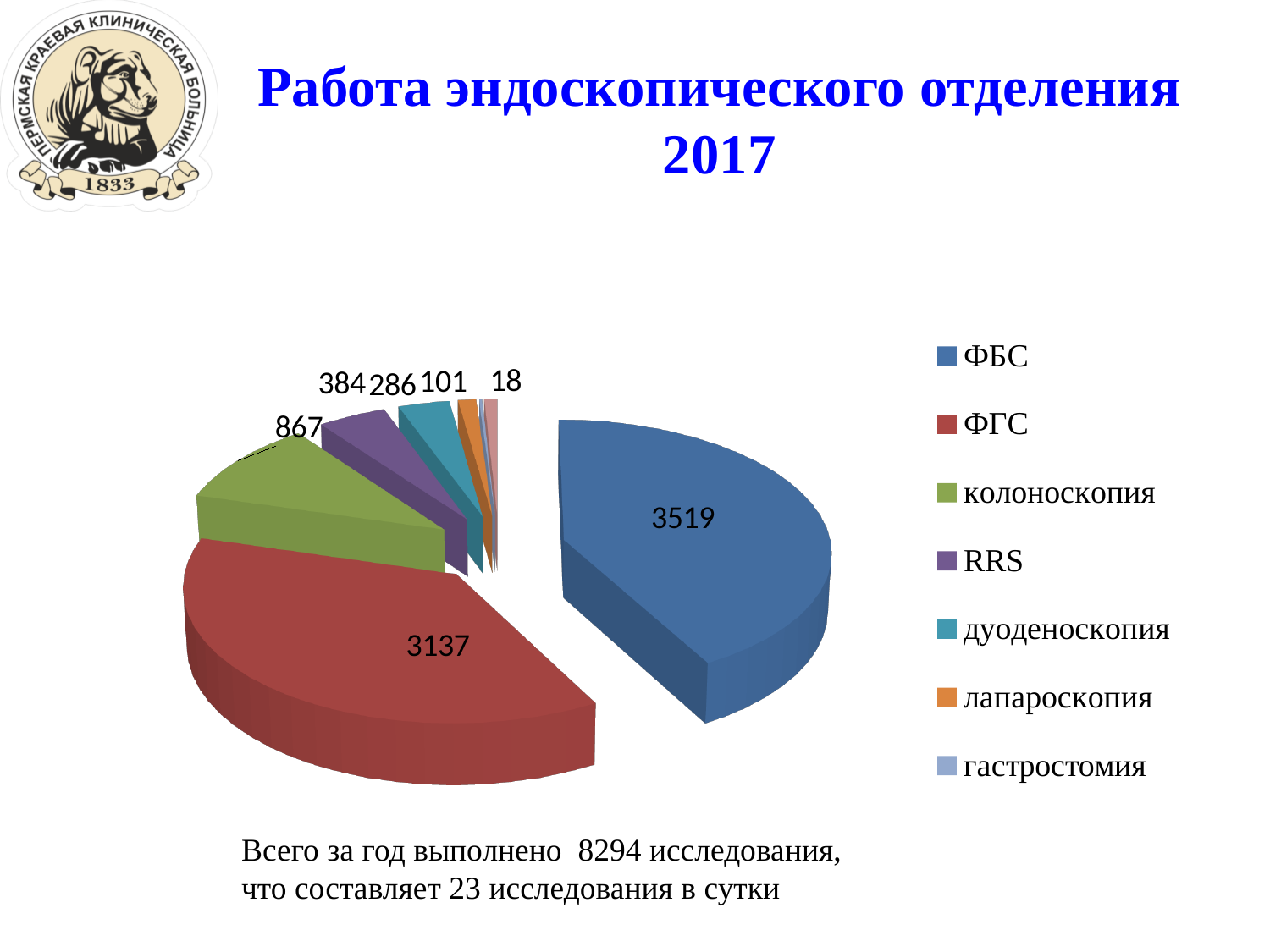
What is the difference between the values for ФБС and ФГС? 382 Which is larger, the value for дуоденоскопия or the value for лапароскопия? дуоденоскопия Which category has the largest slice of the pie? ФБС What is the value for ФГС? 3137 What is the value for ФБС? 3519 What is the value for колоноскопия? 867 What is the value for RRS? 384 Which category has the smallest slice of the pie? гастростомия What is the title of the slide containing the chart? Работа эндоскопического отделения 2017 What type of chart is shown on the slide? pie chart What is the value for гастростомия? 18